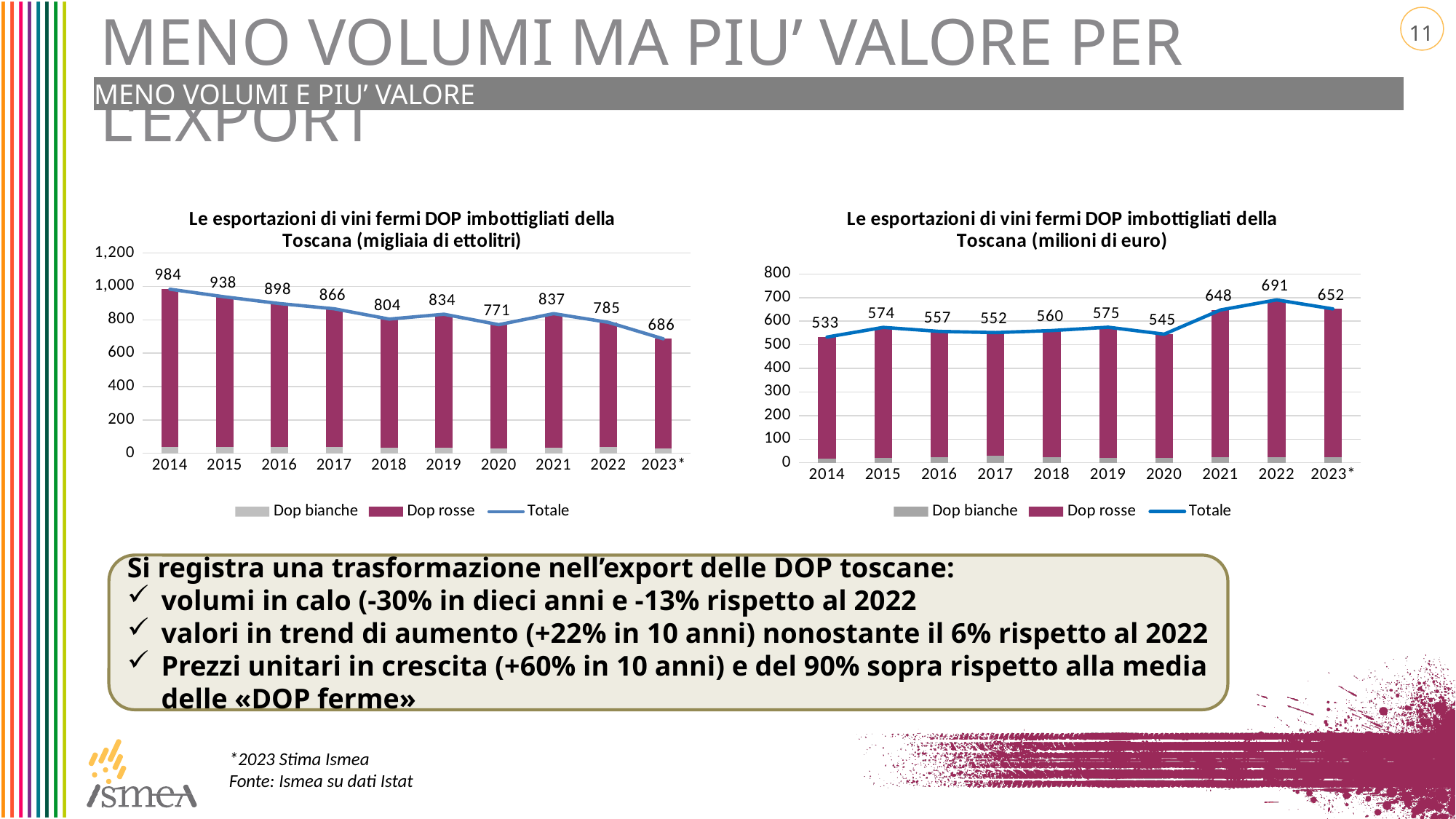
In the left chart (migliaia di ettolitri), what is the difference between the total values for 2014 and 2023*? 298 In the left chart (migliaia di ettolitri), what is the total value shown for 2014? 984 In the right chart (milioni di euro), what is the total value shown for 2022? 691 In the right chart (milioni di euro), is the total value for 2021 greater or less than 600? greater In the right chart (milioni di euro), which year has the highest total value? 2022 In the left chart (migliaia di ettolitri), which year has the lowest total value? 2023* In the left chart (migliaia di ettolitri), which year has a larger total value, 2019 or 2020? 2019 In the right chart (milioni di euro), what is the difference between the total values for 2022 and 2023*? 39 How many years are shown on the x axis of the left chart (migliaia di ettolitri)? 10 What is the overall trend of the total values in the left chart (migliaia di ettolitri) from 2014 to 2023*? falling How many series does the legend of the right chart (milioni di euro) list? 3 In the right chart (milioni di euro), which year has the lowest total value? 2014